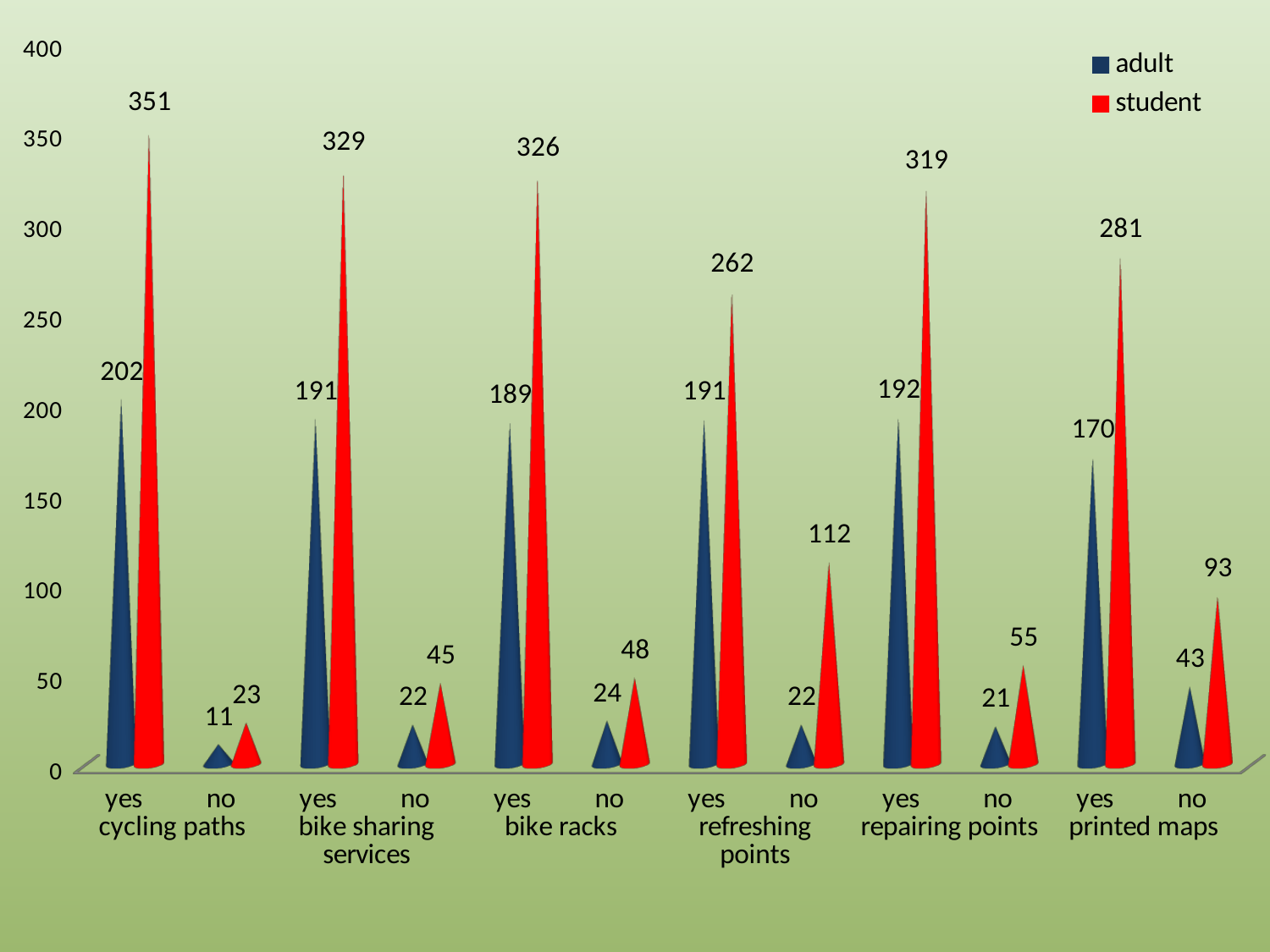
What is the adult value for 'yes' under printed maps? 170 Which category has the lowest adult value? no, cycling paths What is the difference between the student and adult values for 'yes' under bike sharing services? 138 What is the student value for 'no' under refreshing points? 112 Which is larger: the student value for 'no' under printed maps or the student value for 'no' under repairing points? no, printed maps Which category has the highest student value? yes, cycling paths Is the adult value for 'yes' under refreshing points greater or less than 200? less What colour represents the student series? red What is the adult value for 'no' under repairing points? 21 What kind of chart is shown on the slide? bar chart How many series does the legend list? 2 What is the student value for 'yes' under cycling paths? 351